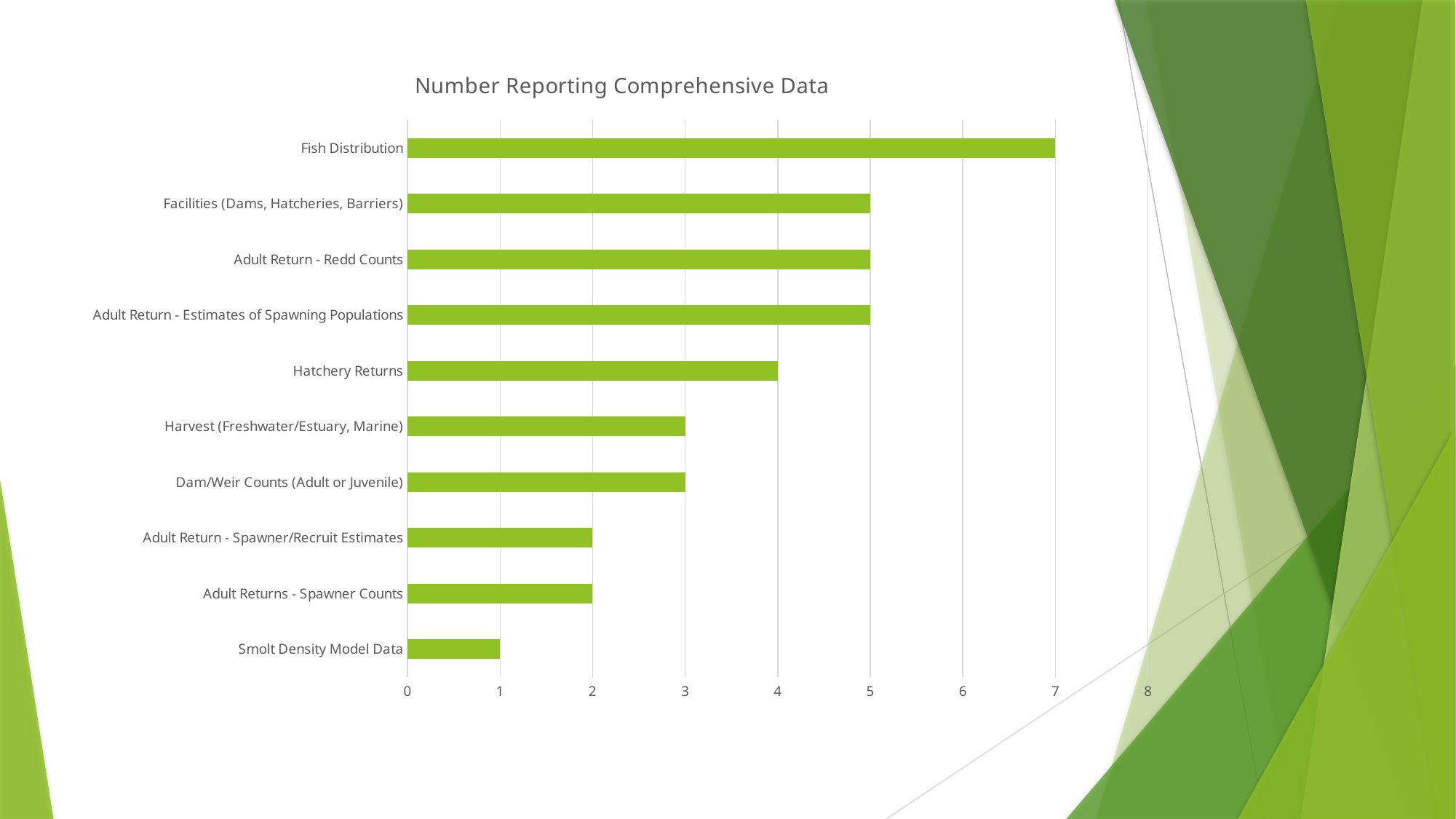
Is the value for Adult Return - Redd Counts greater or less than 4? greater What is the difference between the values for Fish Distribution and Hatchery Returns? 3 What is the title of the chart? Number Reporting Comprehensive Data What kind of chart is shown on the slide? Bar chart What is the value for Smolt Density Model Data? 1 Which category has the highest value? Fish Distribution How many categories are shown in the chart? 10 What is the value for Fish Distribution? 7 What is the value for Hatchery Returns? 4 Which is larger, the value for Facilities (Dams, Hatcheries, Barriers) or the value for Dam/Weir Counts (Adult or Juvenile)? Facilities (Dams, Hatcheries, Barriers) What is the value for Harvest (Freshwater/Estuary, Marine)? 3 Which category has the lowest value? Smolt Density Model Data